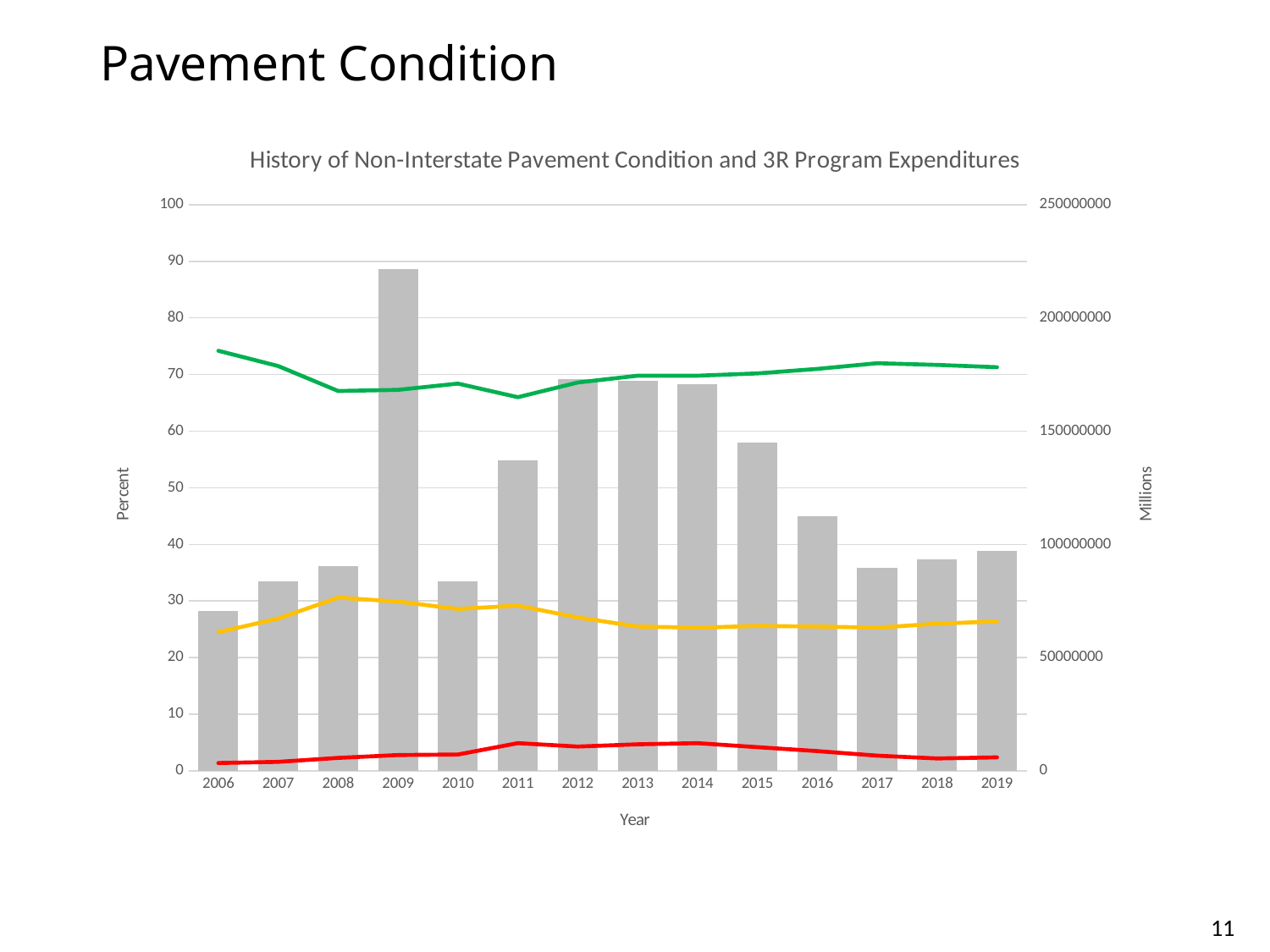
Is the green line's value for 2006 greater or less than 70 on the left axis? greater What is the title of the chart? History of Non-Interstate Pavement Condition and 3R Program Expenditures In which year is the gray bar the shortest? 2006 Is the gray bar for 2009 greater or less than 200000000 on the right axis? greater Which year has the taller gray bar, 2016 or 2017? 2016 Do the gray bars rise or fall from 2014 to 2017? fall In which year is the gray bar the tallest? 2009 Is the yellow line's value for 2013 greater or less than 30 on the left axis? less What kind of chart is shown on the slide? A combined bar and line chart What is the label of the left vertical axis? Percent How many years are shown along the x axis of the chart? 14